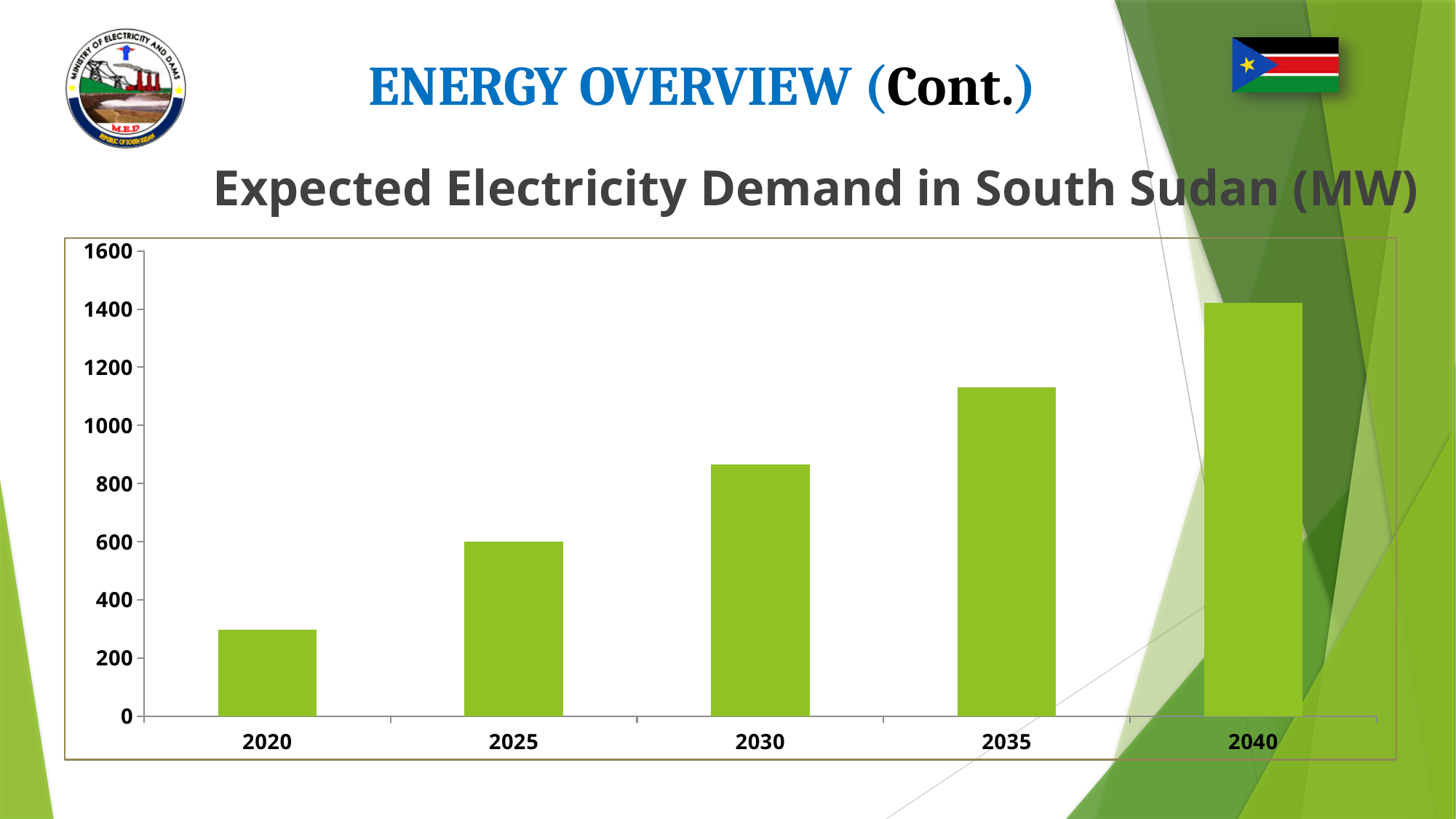
Is the value for 2030 greater or less than 800? greater Which is larger, the value for 2025 or the value for 2035? 2035 Which year has the lowest expected electricity demand? 2020 How many years are shown on the x axis of the chart? 5 What is the title of the chart? Expected Electricity Demand in South Sudan (MW) Is the value for 2040 greater or less than 1600? less Does the expected electricity demand rise or fall from 2020 to 2040? rise Which year has the highest expected electricity demand? 2040 What kind of chart is shown on the slide? bar chart What colour are the bars in the chart? green Is the value for 2020 greater or less than 400? less